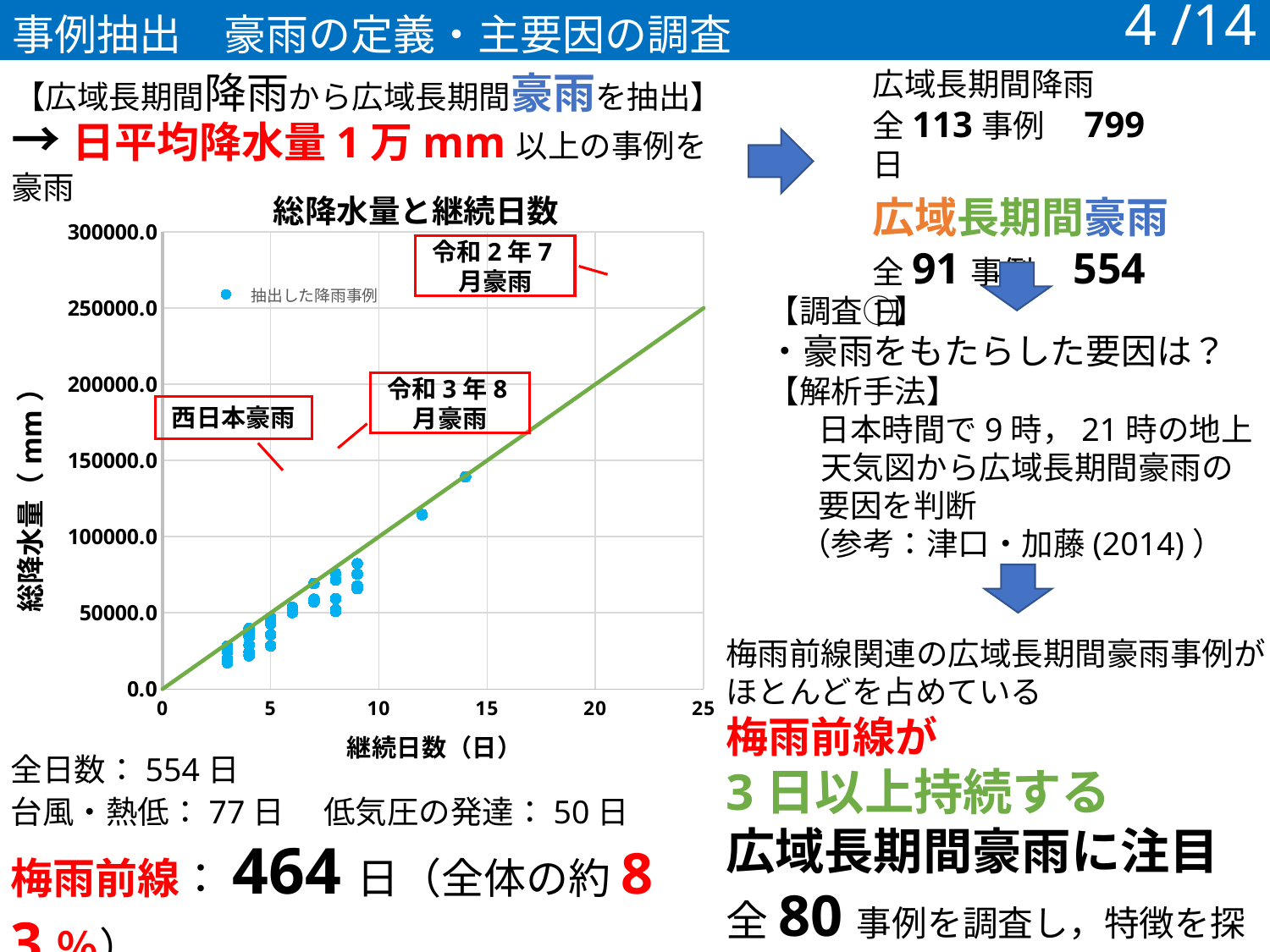
What kind of chart is shown on the slide? scatter chart Are the total precipitation values for the points at 3 days greater or less than 50000.0? less What is the title of the chart? 総降水量と継続日数 At how many days of duration does the point with the highest total precipitation lie? 14 Is the total precipitation value for the point at 14 days greater or less than 100000.0? greater How many series does the chart legend list? 1 What is the maximum value shown on the y axis of the chart? 300000.0 What is the label of the x axis of the chart? 継続日数（日） Is the total precipitation value for the point at 12 days greater or less than 100000.0? greater What is the maximum value shown on the x axis of the chart? 25 Which has the larger total precipitation: the point at 14 days or the point at 12 days? the point at 14 days